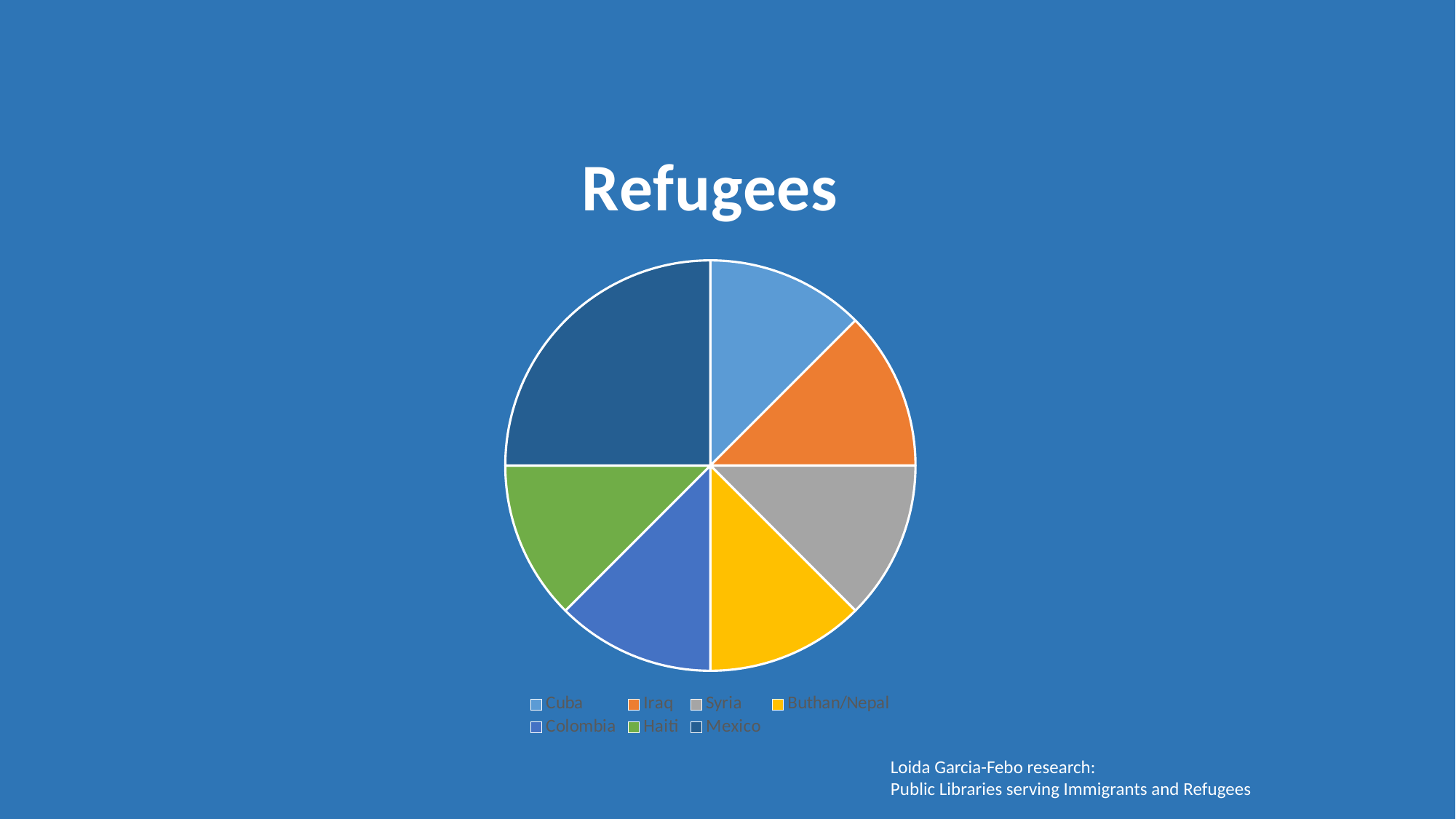
How many categories (slices) does the pie chart have? 7 What is the title of the chart? Refugees Which slice is larger, Mexico or Cuba? Mexico What kind of chart is shown on the slide? pie chart Which slice is larger, Mexico or Syria? Mexico Which slice is larger, Mexico or Haiti? Mexico Which category has the largest slice in the pie chart? Mexico Which category is shown in green in the pie chart? Haiti